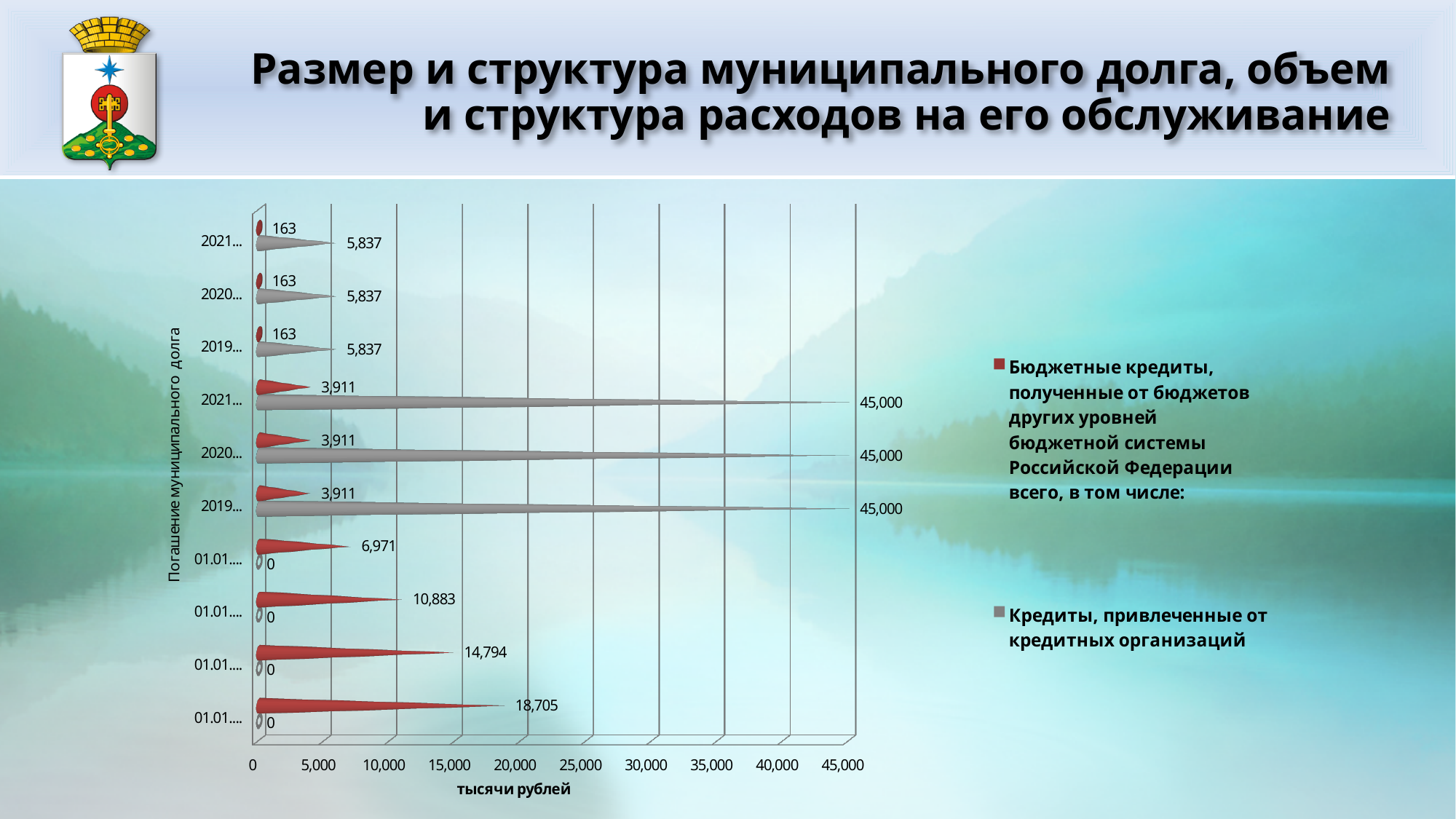
For the topmost category, which series has the larger value: the red series or the grey series? The grey series (Кредиты, привлеченные от кредитных организаций) For the topmost category, what is the difference between the grey series value and the red series value? 5,674 What is the value of the red series (Бюджетные кредиты) for the bottom category of the chart? 18,705 What is the largest value labelled anywhere on the chart? 45,000 How many series does the chart legend list? 2 What is the difference between the red series values of the bottom category and the category directly above it? 3,911 What kind of chart is shown on the slide? Bar chart What is the value of the grey series (Кредиты, привлеченные от кредитных организаций) for the topmost category of the chart? 5,837 How many categories are plotted on the vertical axis of the chart? 10 What unit label is shown under the horizontal axis of the chart? тысячи рублей What is the value of the grey series (Кредиты, привлеченные от кредитных организаций) for the bottom category of the chart? 0 Reading the bottom four categories from bottom to top, do the red series values rise or fall? Fall